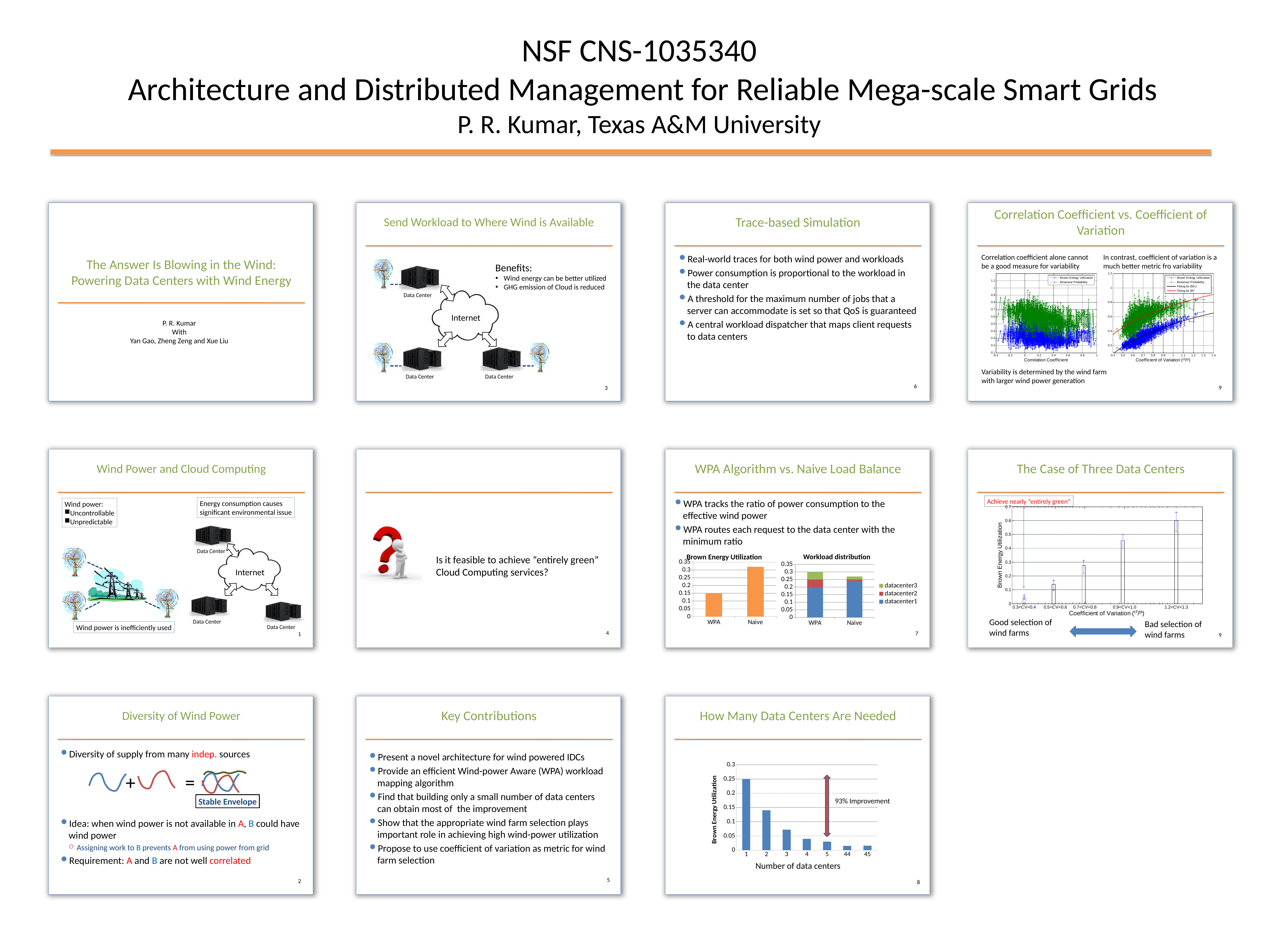
On the 'Brown Energy Utilization' chart in the 'WPA Algorithm vs. Naive Load Balance' slide, is the value for WPA greater or less than 0.2? less On the chart in 'The Case of Three Data Centers' slide, is the value for 0.9<CV<1.0 greater or less than 0.4? greater On the chart in 'The Case of Three Data Centers' slide, which coefficient of variation category has the highest Brown Energy Utilization? 1.2<CV<1.3 What kind of chart is the 'Workload distribution' chart in the 'WPA Algorithm vs. Naive Load Balance' slide? Stacked bar chart On the chart in the 'How Many Data Centers Are Needed' slide, is the value for 1 data center greater or less than 0.2? greater On the 'Brown Energy Utilization' chart in the 'WPA Algorithm vs. Naive Load Balance' slide, which of WPA or Naive has the larger value? Naive On the chart in 'The Case of Three Data Centers' slide, which coefficient of variation category has the lowest Brown Energy Utilization? 0.3<CV<0.4 On the chart in the 'How Many Data Centers Are Needed' slide, does Brown Energy Utilization rise or fall as the number of data centers increases? fall On the chart in 'The Case of Three Data Centers' slide, how many coefficient of variation categories are shown on the x axis? 5 On the 'Workload distribution' chart in the 'WPA Algorithm vs. Naive Load Balance' slide, how many series does the legend list? 3 On the chart in the 'How Many Data Centers Are Needed' slide, what improvement percentage is annotated next to the arrow? 93% Improvement